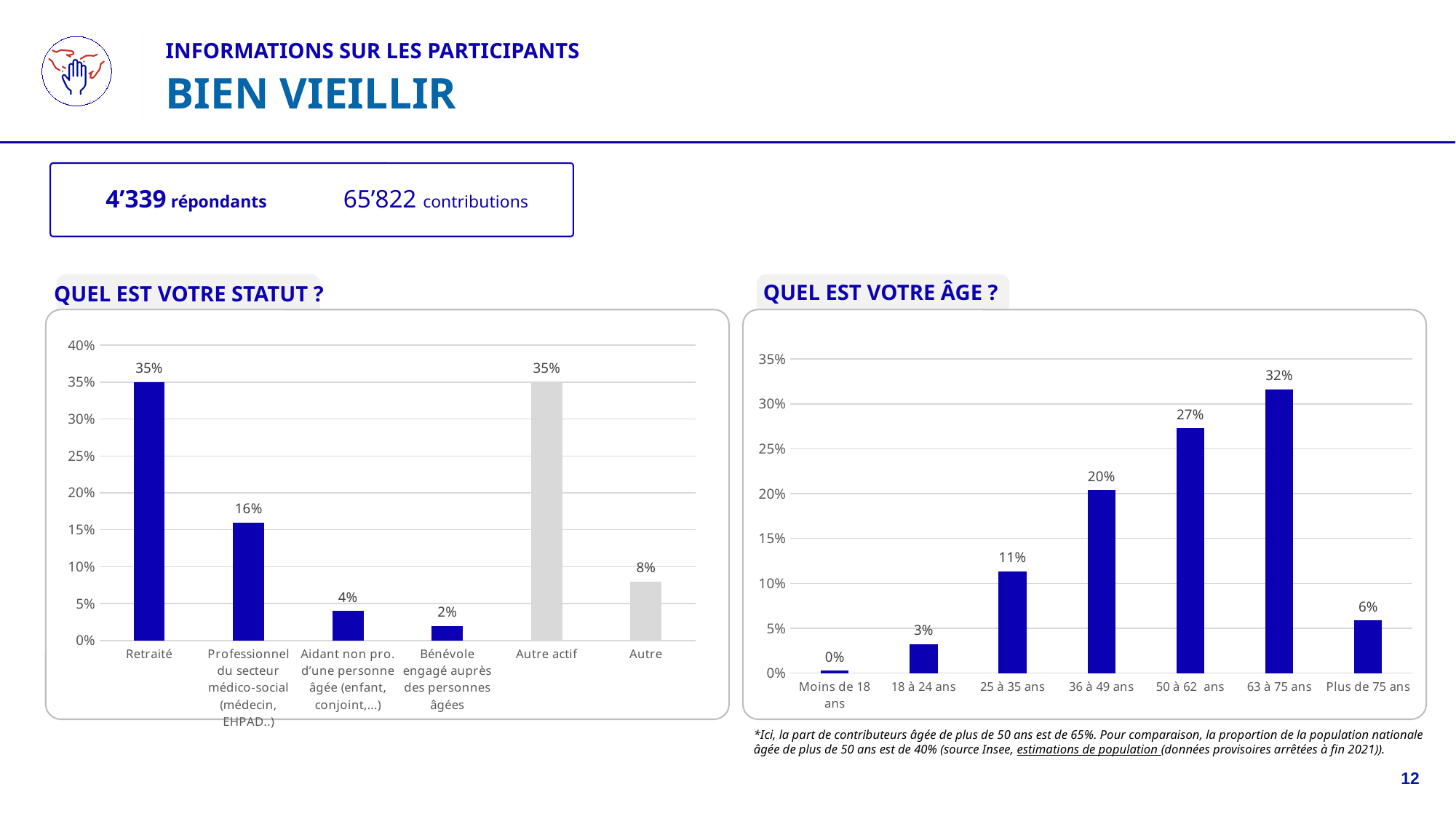
In the 'QUEL EST VOTRE STATUT ?' chart, which category has the lowest value? Bénévole engagé auprès des personnes âgées In the 'QUEL EST VOTRE ÂGE ?' chart, which is larger: 36 à 49 ans or Plus de 75 ans? 36 à 49 ans What type of chart is 'QUEL EST VOTRE ÂGE ?'? Bar chart In the 'QUEL EST VOTRE STATUT ?' chart, which bars are shown in grey rather than blue? Autre actif and Autre In the 'QUEL EST VOTRE ÂGE ?' chart, which age group has the lowest value? Moins de 18 ans In the 'QUEL EST VOTRE STATUT ?' chart, how many categories are shown on the x axis? 6 In the 'QUEL EST VOTRE ÂGE ?' chart, what is the difference between 63 à 75 ans and 25 à 35 ans? 21% In the 'QUEL EST VOTRE ÂGE ?' chart, which age group has the highest value? 63 à 75 ans In the 'QUEL EST VOTRE STATUT ?' chart, what is the value for Retraité? 35% In the 'QUEL EST VOTRE STATUT ?' chart, what is the value for Professionnel du secteur médico-social? 16% In the 'QUEL EST VOTRE ÂGE ?' chart, what is the value for 50 à 62 ans? 27% In the 'QUEL EST VOTRE STATUT ?' chart, what is the difference between Autre actif and Autre? 27%